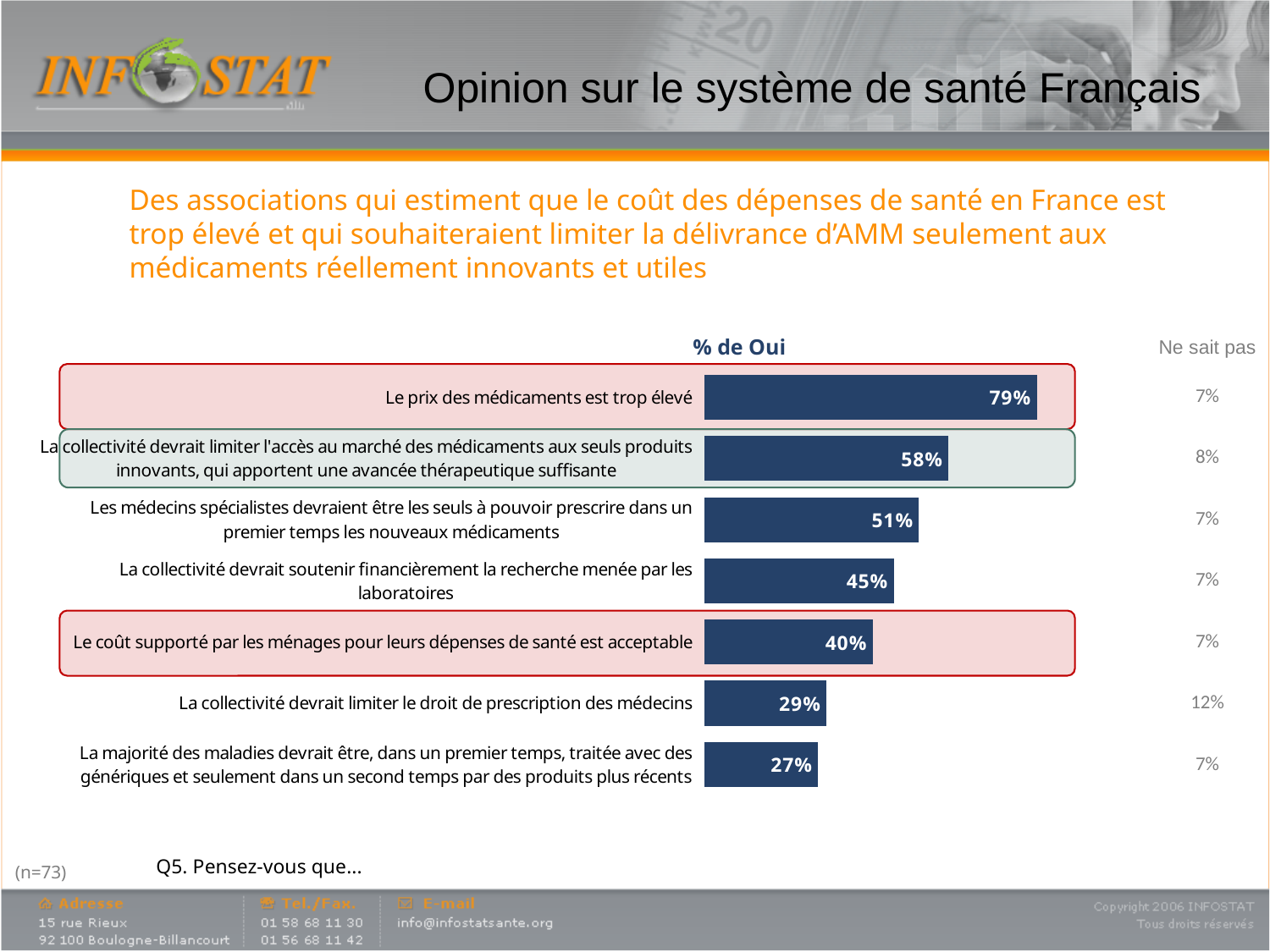
What is the sample size (n) indicated on the slide? n=73 Which statement has the lowest '% de Oui'? La majorité des maladies devrait être, dans un premier temps, traitée avec des génériques et seulement dans un second temps par des produits plus récents Do the '% de Oui' values increase or decrease from the top bar to the bottom bar? Decrease How many statements are plotted in the bar chart? 7 What is the '% de Oui' value for 'La collectivité devrait soutenir financièrement la recherche menée par les laboratoires'? 45% What kind of chart is shown on the slide? Bar chart What is the '% de Oui' value for 'La collectivité devrait limiter le droit de prescription des médecins'? 29% Which statement has the highest '% de Oui'? Le prix des médicaments est trop élevé What is the 'Ne sait pas' percentage for 'La collectivité devrait limiter le droit de prescription des médecins'? 12% What is the difference in '% de Oui' between 'Le prix des médicaments est trop élevé' and 'Le coût supporté par les ménages pour leurs dépenses de santé est acceptable'? 39% Which has a higher '% de Oui': 'Les médecins spécialistes devraient être les seuls à pouvoir prescrire dans un premier temps les nouveaux médicaments' or 'La collectivité devrait limiter le droit de prescription des médecins'? Les médecins spécialistes devraient être les seuls à pouvoir prescrire dans un premier temps les nouveaux médicaments What percentage of respondents answered 'Oui' to 'Le prix des médicaments est trop élevé'? 79%